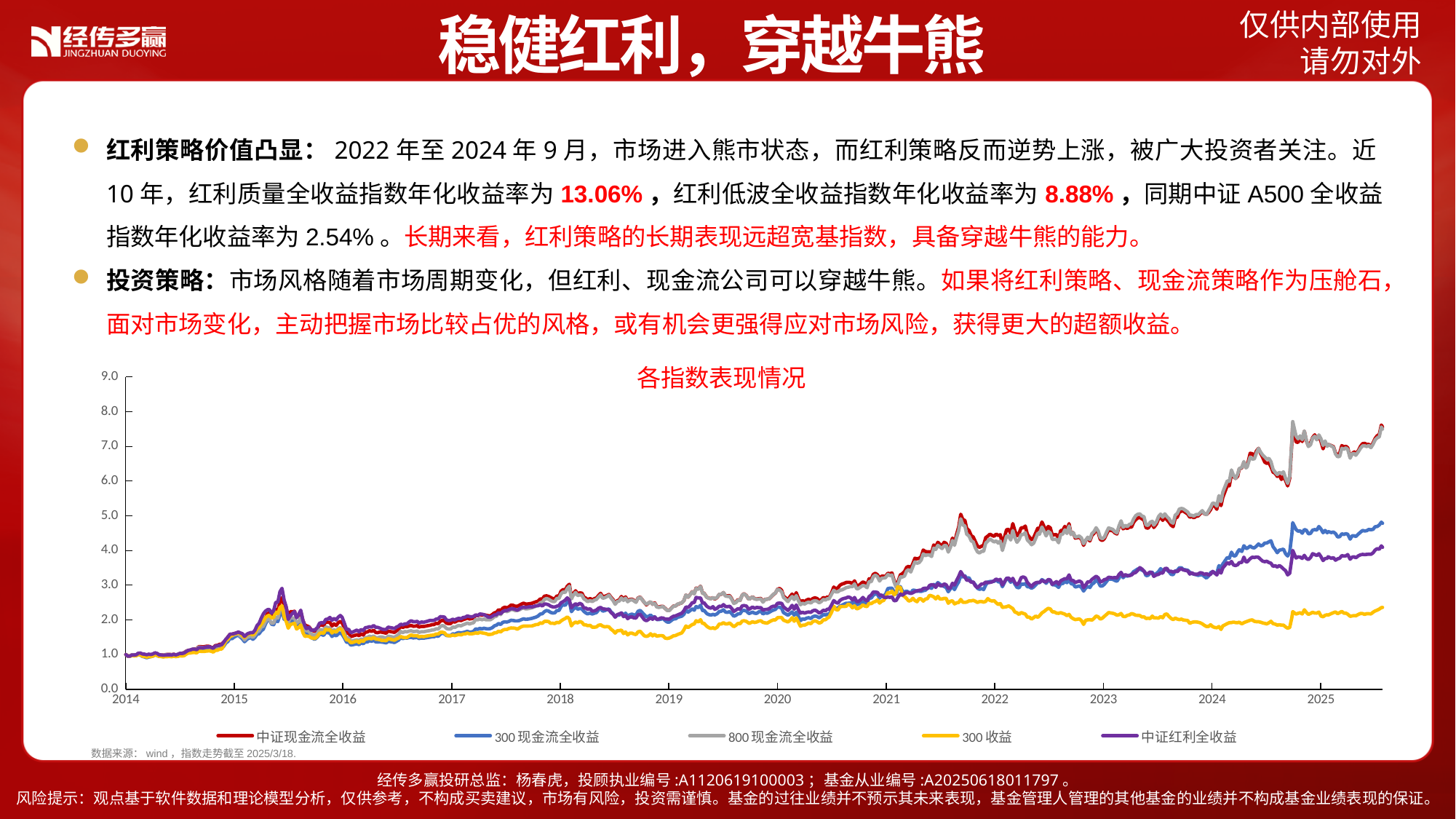
Is the value of 300收益 at the right end of the chart greater or less than 3.0? less Which series has the lowest value at the right end of the chart (2025)? 300收益 Is the value of 中证红利全收益 at the right end of the chart greater or less than 3.0? greater How many year labels are shown on the x axis of the chart? 12 Does the 中证现金流全收益 line overall rise or fall from 2014 to 2025? rise What is the title of the chart on the slide? 各指数表现情况 What colour is the line for 300收益 in the chart? yellow What kind of chart is shown under the title 各指数表现情况? line chart Is the value of 中证现金流全收益 at the right end of the chart greater or less than 6.0? greater At the right end of the chart, is 300收益 higher or lower than 中证红利全收益? lower At the right end of the chart, is 300现金流全收益 higher or lower than 中证红利全收益? higher How many series does the legend of the chart list? 5